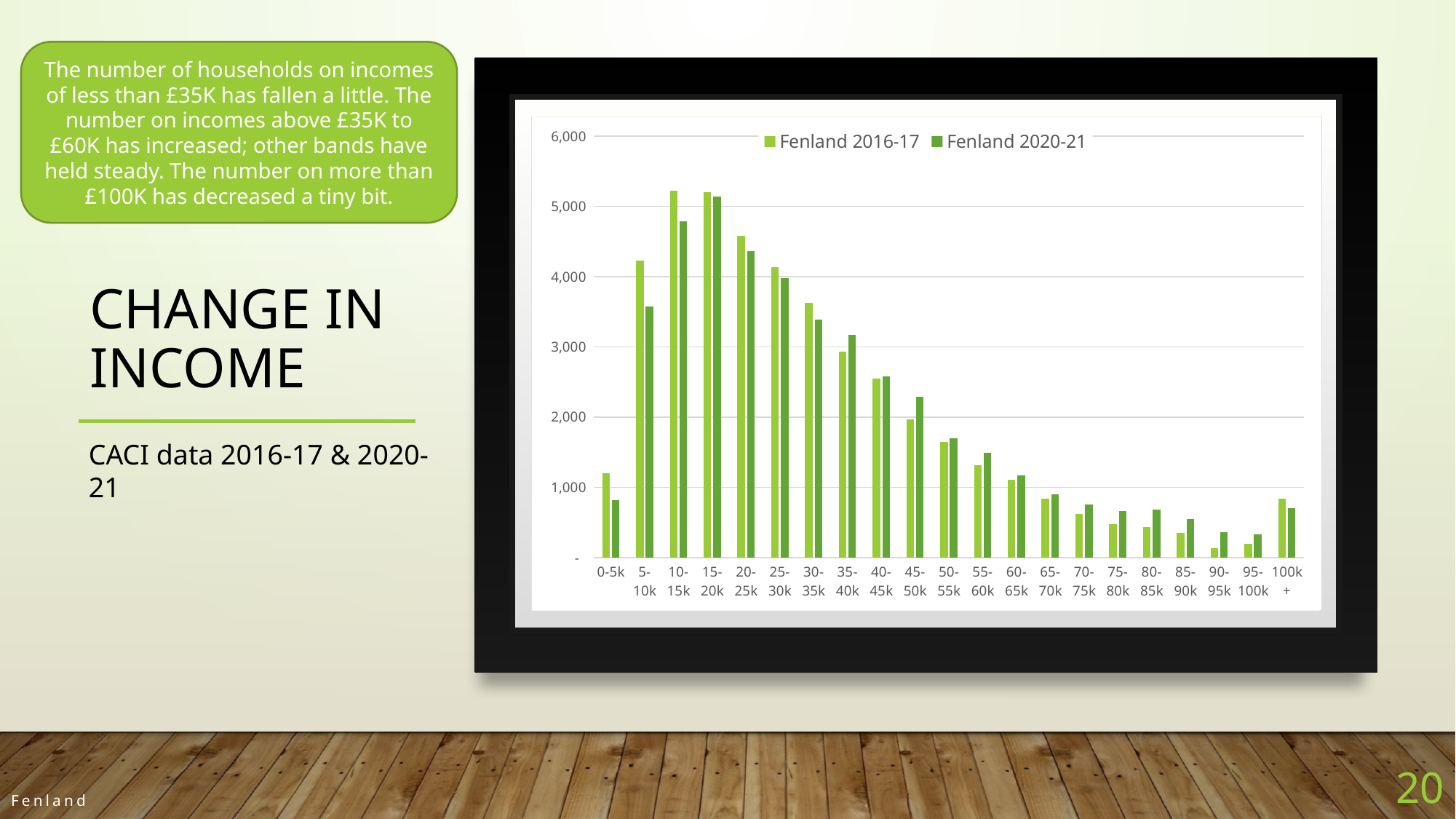
How many income bands are shown on the x axis? 21 Which income band has the highest value for Fenland 2020-21? 15-20k Is the Fenland 2016-17 value for the 0-5k band greater or less than 1,000? greater Which income band has the lowest value for Fenland 2016-17? 90-95k What kind of chart is shown on the slide? bar chart What are the two series named in the legend? Fenland 2016-17 and Fenland 2020-21 For the 5-10k band, which series is larger, Fenland 2016-17 or Fenland 2020-21? Fenland 2016-17 For the 45-50k band, which series is larger, Fenland 2016-17 or Fenland 2020-21? Fenland 2020-21 Do the Fenland 2016-17 values generally rise or fall from the 15-20k band to the 90-95k band? fall How many series does the legend list? 2 Is the Fenland 2020-21 value for the 5-10k band greater or less than 4,000? less Is the Fenland 2020-21 value for the 55-60k band greater or less than 1,000? greater